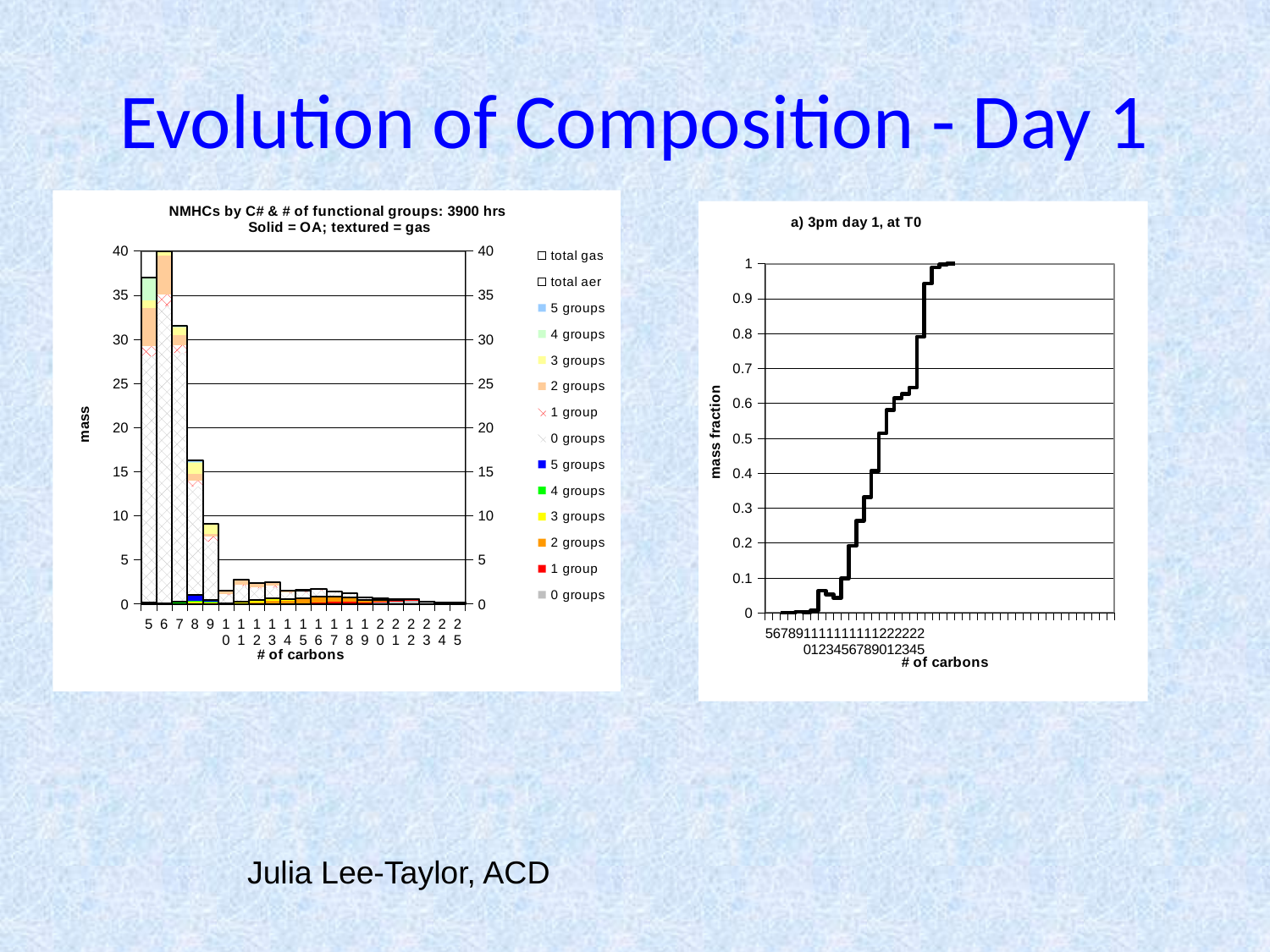
In the left chart, is the total bar height for 7 carbons greater or less than 25? greater What kind of chart is the left chart titled 'NMHCs by C# & # of functional groups: 3900 hrs'? stacked bar chart In the left chart, which bar is taller: 5 carbons or 8 carbons? 5 carbons In the left chart, which number of carbons has the tallest bar? 6 In the left chart, is the total bar height for 8 carbons greater or less than 20? less How many entries does the legend of the left chart list? 14 How many categories (numbers of carbons) are shown on the x axis of the left chart? 21 In the right chart, does the mass fraction rise or fall as the number of carbons increases? rises In the left chart, is the total bar height for 9 carbons greater or less than 5? greater What kind of chart is the right chart titled 'a) 3pm day 1, at T0'? line chart What is the label of the y axis of the right chart? mass fraction